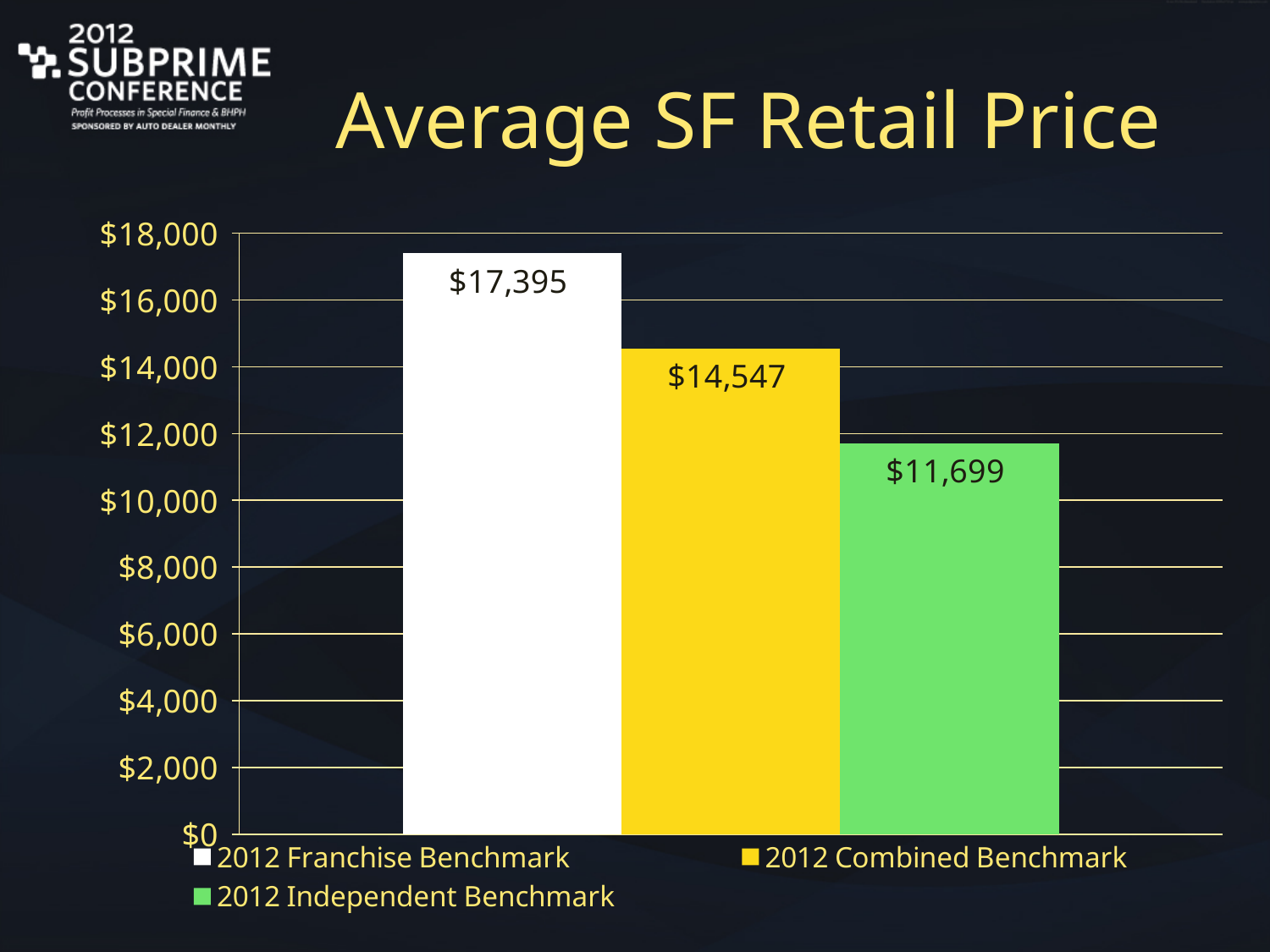
What is the difference between the 2012 Franchise Benchmark and the 2012 Independent Benchmark? $5,696 Which series has the lowest average SF retail price? 2012 Independent Benchmark Is the value for the 2012 Independent Benchmark greater or less than $12,000? less What is the title of the chart? Average SF Retail Price What is the value for the 2012 Independent Benchmark? $11,699 What is the value for the 2012 Franchise Benchmark? $17,395 Which series has the highest average SF retail price? 2012 Franchise Benchmark What kind of chart is shown on the slide? bar chart Which is larger, the 2012 Combined Benchmark or the 2012 Independent Benchmark? 2012 Combined Benchmark What is the difference between the 2012 Franchise Benchmark and the 2012 Combined Benchmark? $2,848 How many series does the legend list? 3 What is the value for the 2012 Combined Benchmark? $14,547